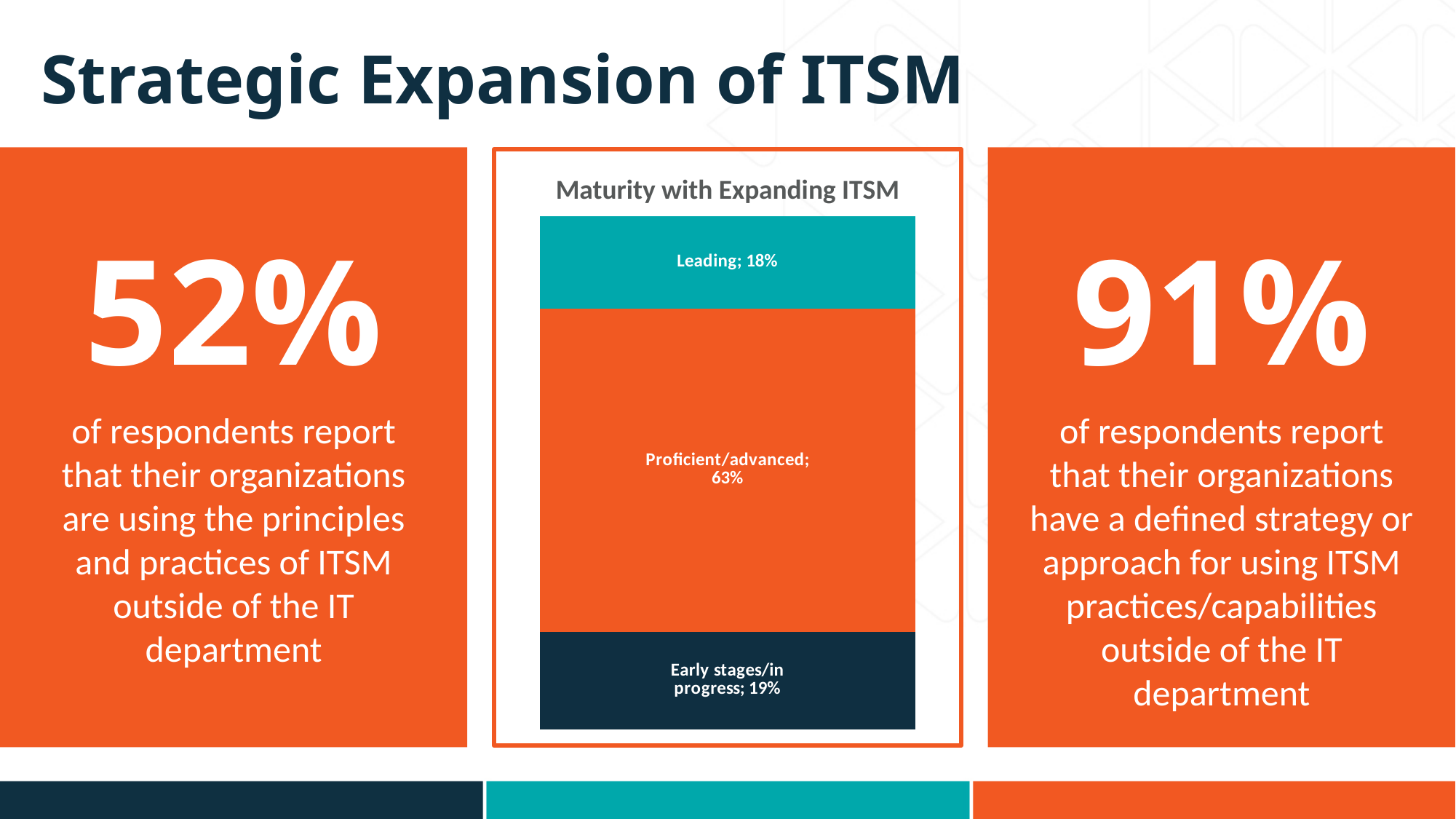
What percentage is shown for the Proficient/advanced segment? 63% What is the title of the chart? Maturity with Expanding ITSM What is the difference between the Early stages/in progress and Leading values? 1% Which segment has the largest value? Proficient/advanced What is the total of all segments in the stacked bar? 100% Which segment has the smallest value? Leading What percentage is shown for the Early stages/in progress segment? 19% What kind of chart is shown on the slide? Stacked bar chart What colour is the Leading segment? Teal What is the difference between the Proficient/advanced and Early stages/in progress values? 44% How many segments make up the stacked bar? 3 What percentage is shown for the Leading segment? 18%